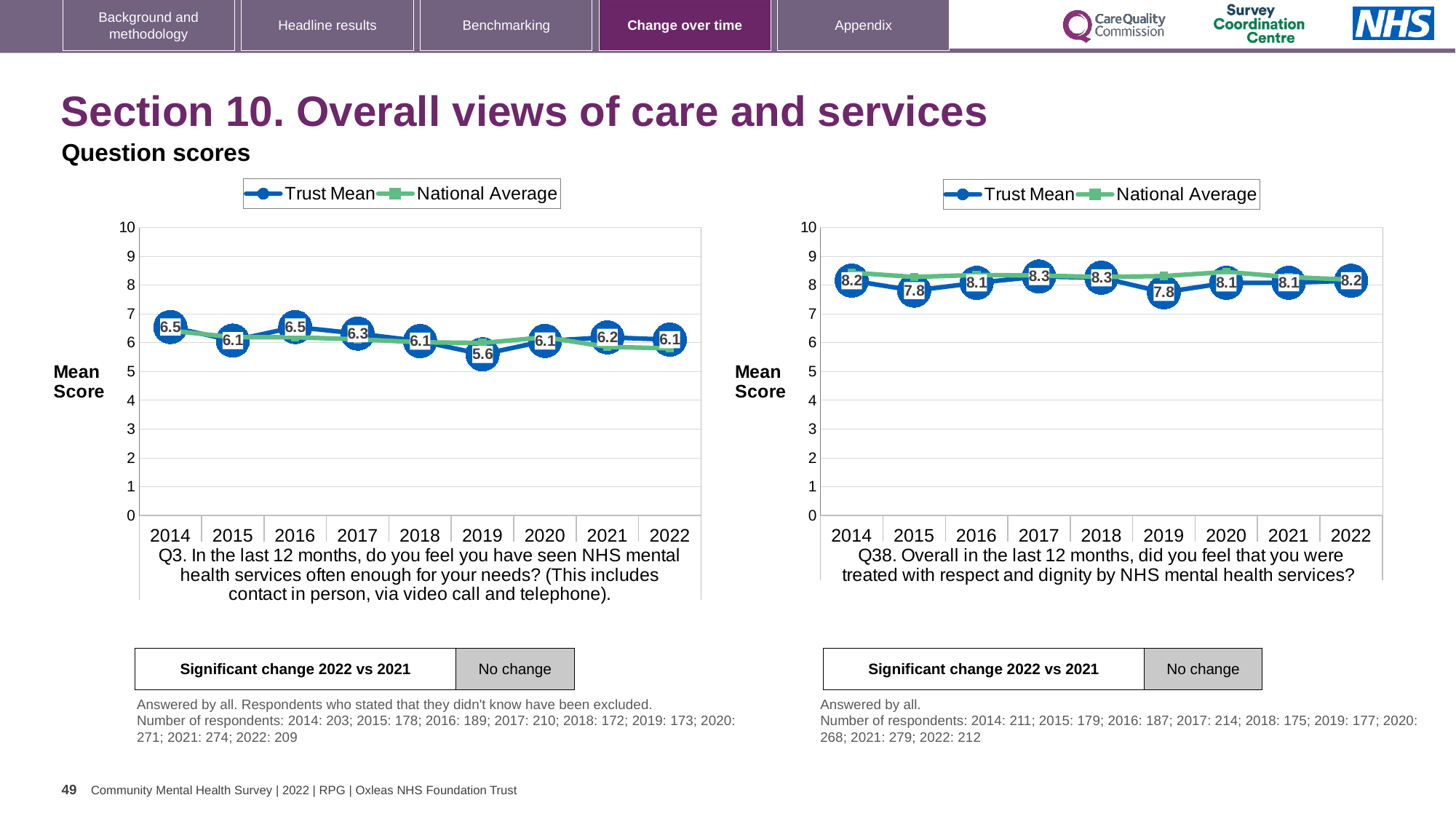
What type of chart is the left chart (Q3)? Line chart How many series does the legend of the right chart (Q38) list? 2 In the right chart (Q38), is the Trust Mean for 2021 greater or less than 7? greater In the right chart (Q38), what is the Trust Mean for 2017? 8.3 In the left chart (Q3), what is the Trust Mean for 2019? 5.6 In the right chart (Q38), which is larger, the Trust Mean for 2018 or for 2019? 2018 In the left chart (Q3), which year has the lowest Trust Mean? 2019 In the left chart (Q3), how many years are shown on the x axis? 9 In the right chart (Q38), what is the Trust Mean for 2015? 7.8 In the left chart (Q3), what is the difference between the Trust Mean in 2014 and in 2019? 0.9 In the left chart (Q3), what is the Trust Mean for 2022? 6.1 In the right chart (Q38), what is the difference between the Trust Mean in 2022 and in 2021? 0.1